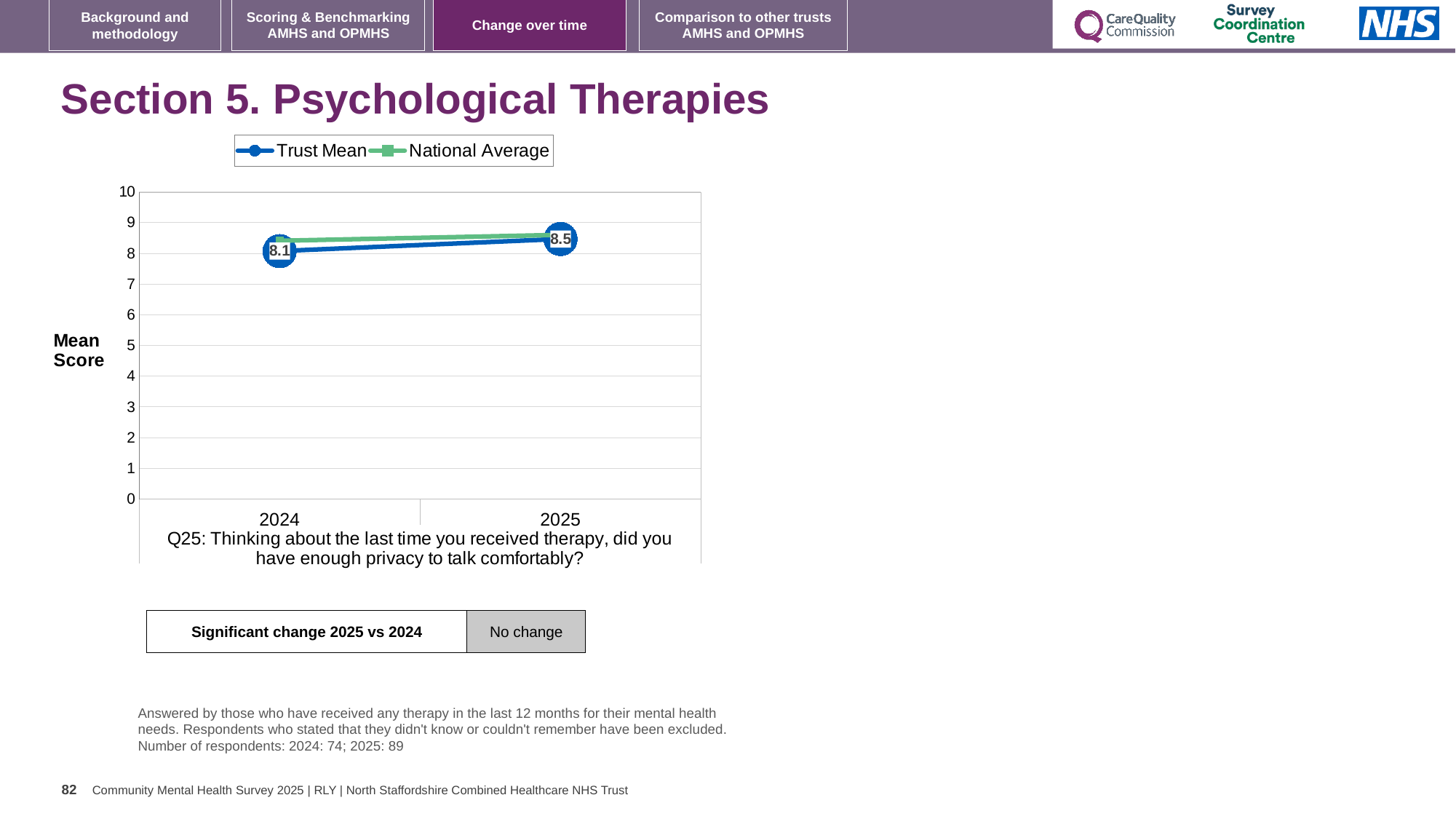
In which year is the Trust Mean score lower? 2024 What is the Trust Mean score for 2024? 8.1 What is the Trust Mean score for 2025? 8.5 How many series does the chart legend list? 2 Does the Trust Mean rise or fall from 2024 to 2025? Rise Is the National Average value for 2025 greater or less than 9? less By how much did the Trust Mean score change from 2024 to 2025? 0.4 How many years are shown on the x axis of the chart? 2 In which year is the Trust Mean score higher? 2025 What kind of chart is shown on the slide? Line chart Is the National Average value for 2024 greater or less than 8? greater Which is larger, the Trust Mean for 2024 or for 2025? 2025